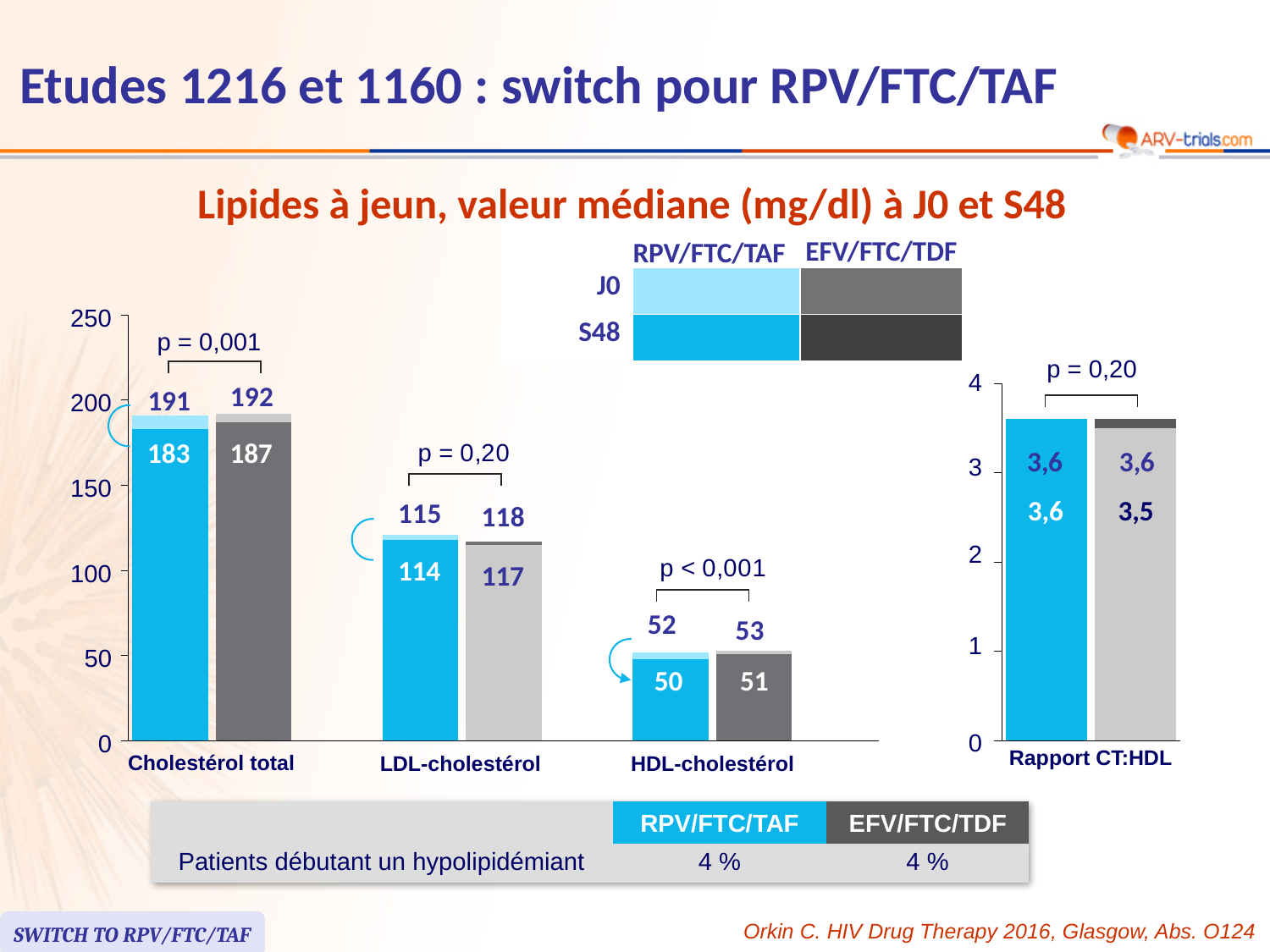
In the Rapport CT:HDL chart, what is the S48 value for EFV/FTC/TDF? 3,5 In the left chart, what is the J0 value for EFV/FTC/TDF for LDL-cholestérol? 118 In the left chart, how many categories are shown on the x axis? 3 In the left chart, what is the J0 value for RPV/FTC/TAF for HDL-cholestérol? 52 In the left chart, what is the difference between the J0 and S48 values for RPV/FTC/TAF for Cholestérol total? 8 What type of chart is used on this slide? Bar chart In the Rapport CT:HDL chart, what is the J0 value for RPV/FTC/TAF? 3,6 In the left chart, which category has the lowest values? HDL-cholestérol In the left chart, what is the S48 value for EFV/FTC/TDF for HDL-cholestérol? 51 What p-value is shown above the HDL-cholestérol bars in the left chart? p < 0,001 In the left chart, which category has the highest values? Cholestérol total In the left chart, what is the S48 value for RPV/FTC/TAF for Cholestérol total? 183